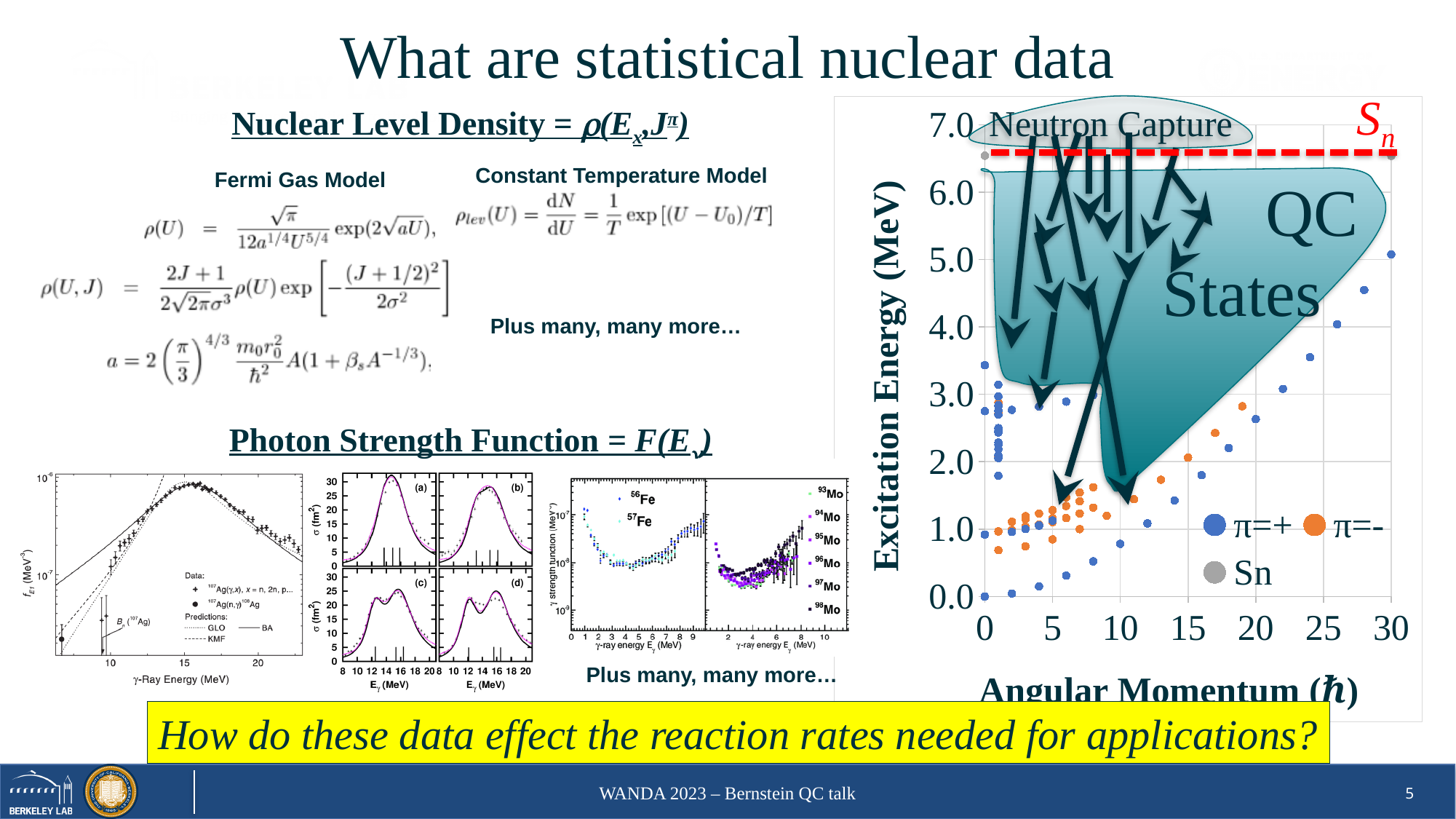
What kind of chart is the large chart on the right of the slide (Excitation Energy vs Angular Momentum)? scatter chart In the Excitation Energy vs Angular Momentum chart, is the π=+ point at angular momentum 30 greater or less than 4.0 MeV? greater In the Excitation Energy vs Angular Momentum chart, what is the highest tick value shown on the x axis? 30 In the Excitation Energy vs Angular Momentum chart, is the Sn (neutron separation energy) dashed line greater or less than 6.0 MeV? greater In the Excitation Energy vs Angular Momentum chart, what is the label of the x axis? Angular Momentum (ħ) In the photon strength function plot showing Mo isotopes (bottom middle), how many isotopes does the legend list? 6 In the photon strength function plot showing Fe isotopes (bottom middle), how many isotopes does the legend list? 2 In the Excitation Energy vs Angular Momentum chart, at angular momentum 30, which is higher: the π=+ point or the Sn point? Sn In the Excitation Energy vs Angular Momentum chart, do the lowest-energy plotted points rise or fall as angular momentum increases along the x axis? rise In the Excitation Energy vs Angular Momentum chart, what is the label of the y axis? Excitation Energy (MeV) In the Excitation Energy vs Angular Momentum chart, how many tick labels are shown on the x axis? 7 In the Excitation Energy vs Angular Momentum chart, how many series does the legend list? 3